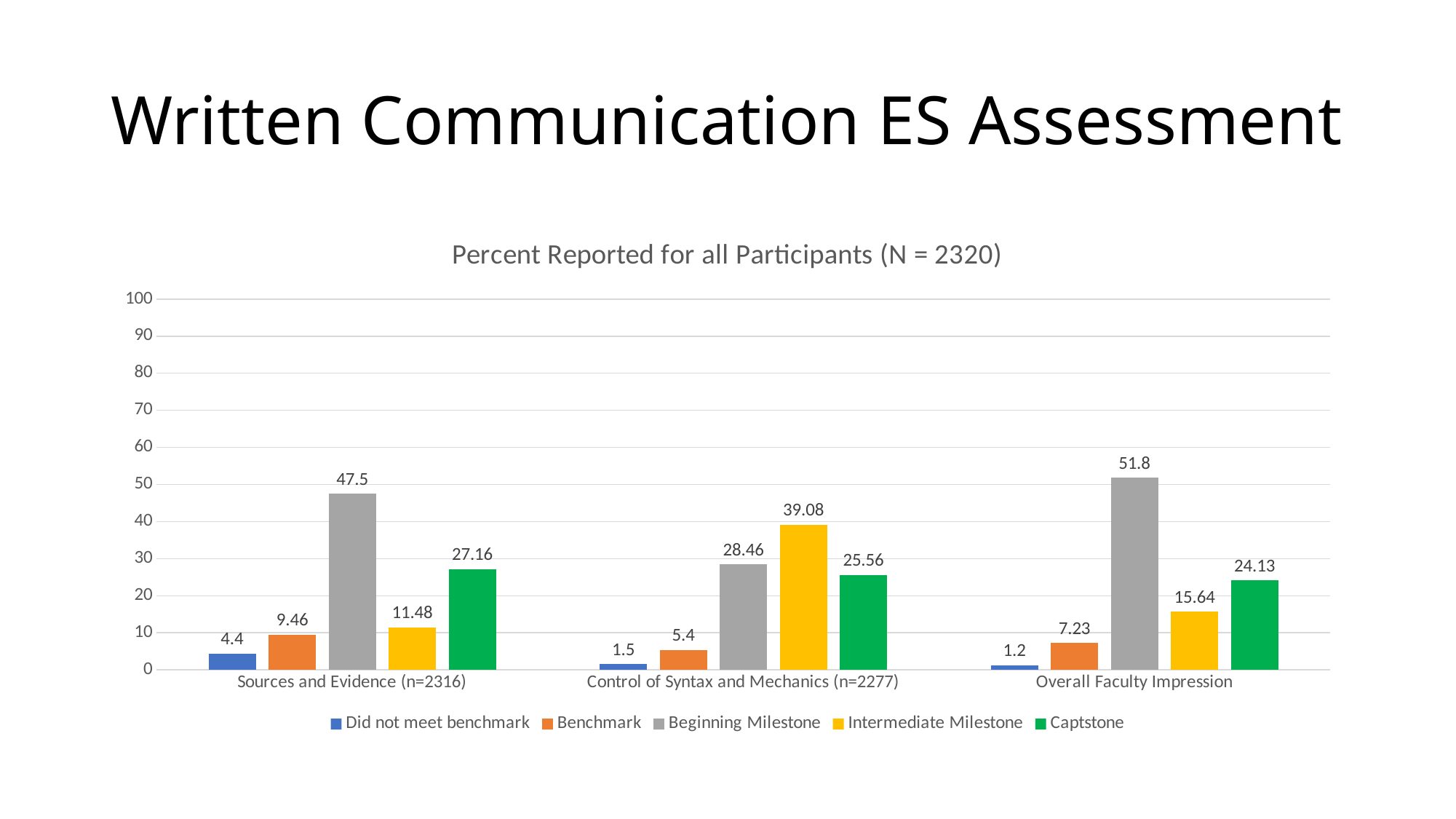
What kind of chart is shown on the slide? Bar chart What is the value for Intermediate Milestone in the Control of Syntax and Mechanics (n=2277) category? 39.08 How many series does the legend list? 5 What is the value for Beginning Milestone in the Sources and Evidence (n=2316) category? 47.5 What is the difference between the Beginning Milestone value and the Captstone value in the Overall Faculty Impression category? 27.67 Which is larger in the Control of Syntax and Mechanics (n=2277) category: Beginning Milestone or Intermediate Milestone? Intermediate Milestone Is the Beginning Milestone value for Overall Faculty Impression greater or less than 50? greater How many categories are shown on the x axis? 3 Which series has the lowest value in the Control of Syntax and Mechanics (n=2277) category? Did not meet benchmark What is the title of the chart? Percent Reported for all Participants (N = 2320) What is the value for Did not meet benchmark in the Overall Faculty Impression category? 1.2 Which series has the highest value in the Overall Faculty Impression category? Beginning Milestone